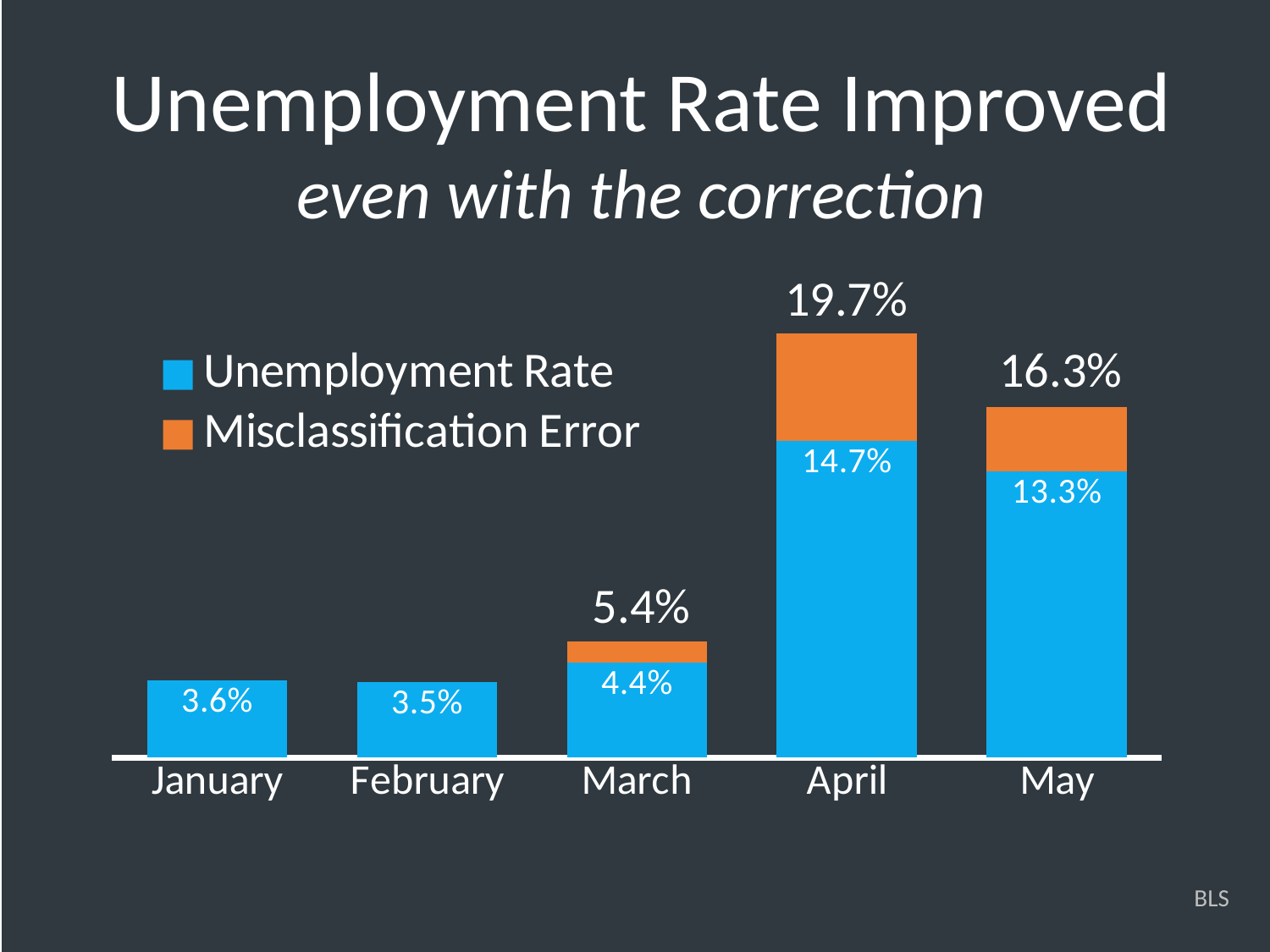
How many series does the legend list? 2 Which month has the highest Unemployment Rate? April Which is larger, the Unemployment Rate for January or for March? March What is the Unemployment Rate for February? 3.5% Which month has the lowest Unemployment Rate? February What kind of chart is shown on the slide? Stacked bar chart What is the difference between the Unemployment Rate for April and the Unemployment Rate for May? 1.4% What is the difference between the total for April (19.7%) and its Unemployment Rate (14.7%), i.e. the Misclassification Error for April? 5.0% What is the total height of the stacked bar for March? 5.4% What is the total height of the stacked bar for May? 16.3% How many months are shown on the x axis? 5 What is the Unemployment Rate for April? 14.7%